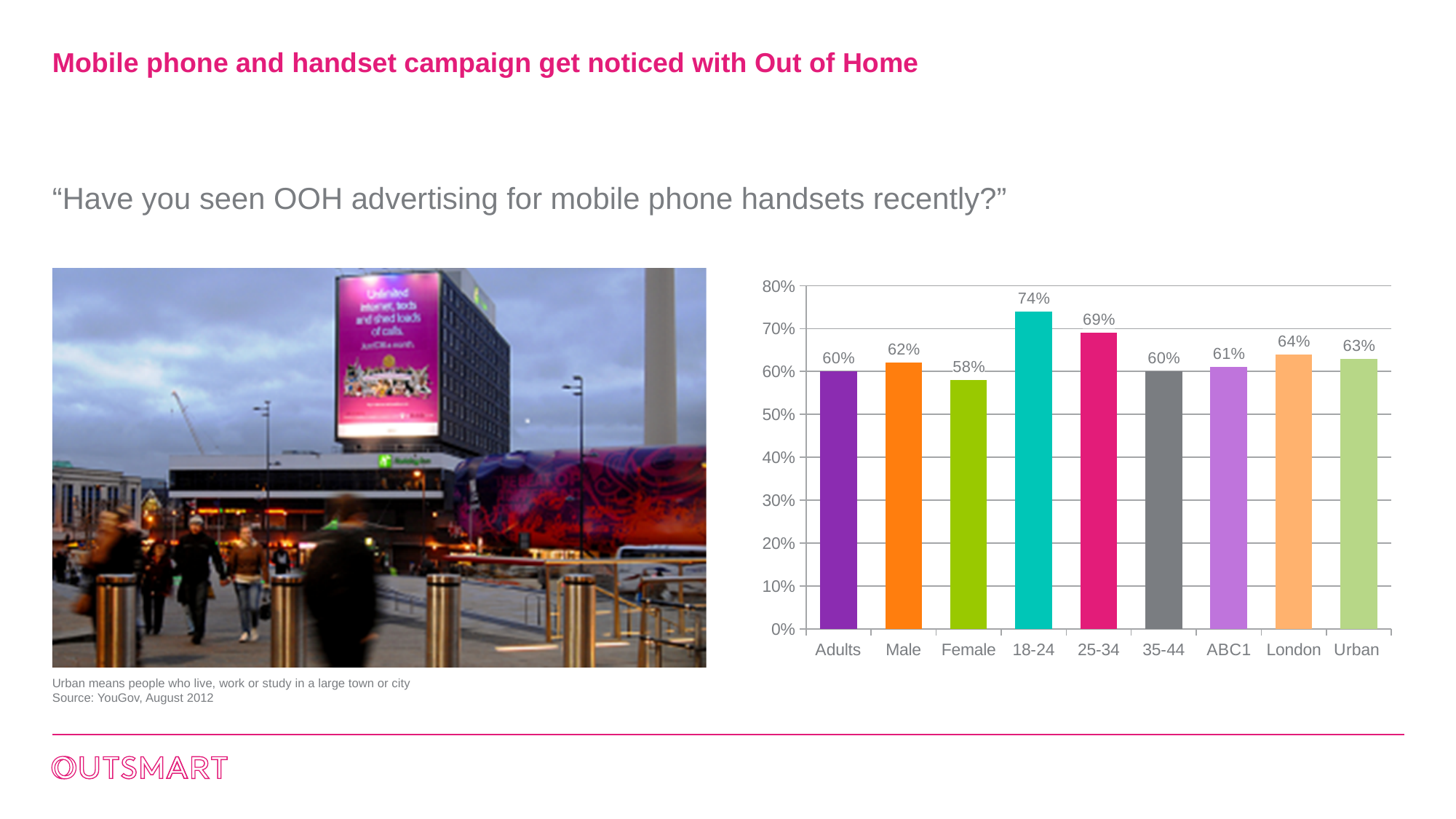
What is the difference between the values for Male and Female? 4% Which category has the lowest value? Female How many categories are shown on the x axis? 9 What is the difference between the values for 18-24 and 25-34? 5% What kind of chart is shown on the slide? Bar chart What is the value for 18-24? 74% Which is larger, the value for London or the value for Urban? London What is the value for London? 64% What is the value for ABC1? 61% Is the value for 25-34 greater or less than 60%? greater What is the value for Female? 58% Which category has the highest value? 18-24